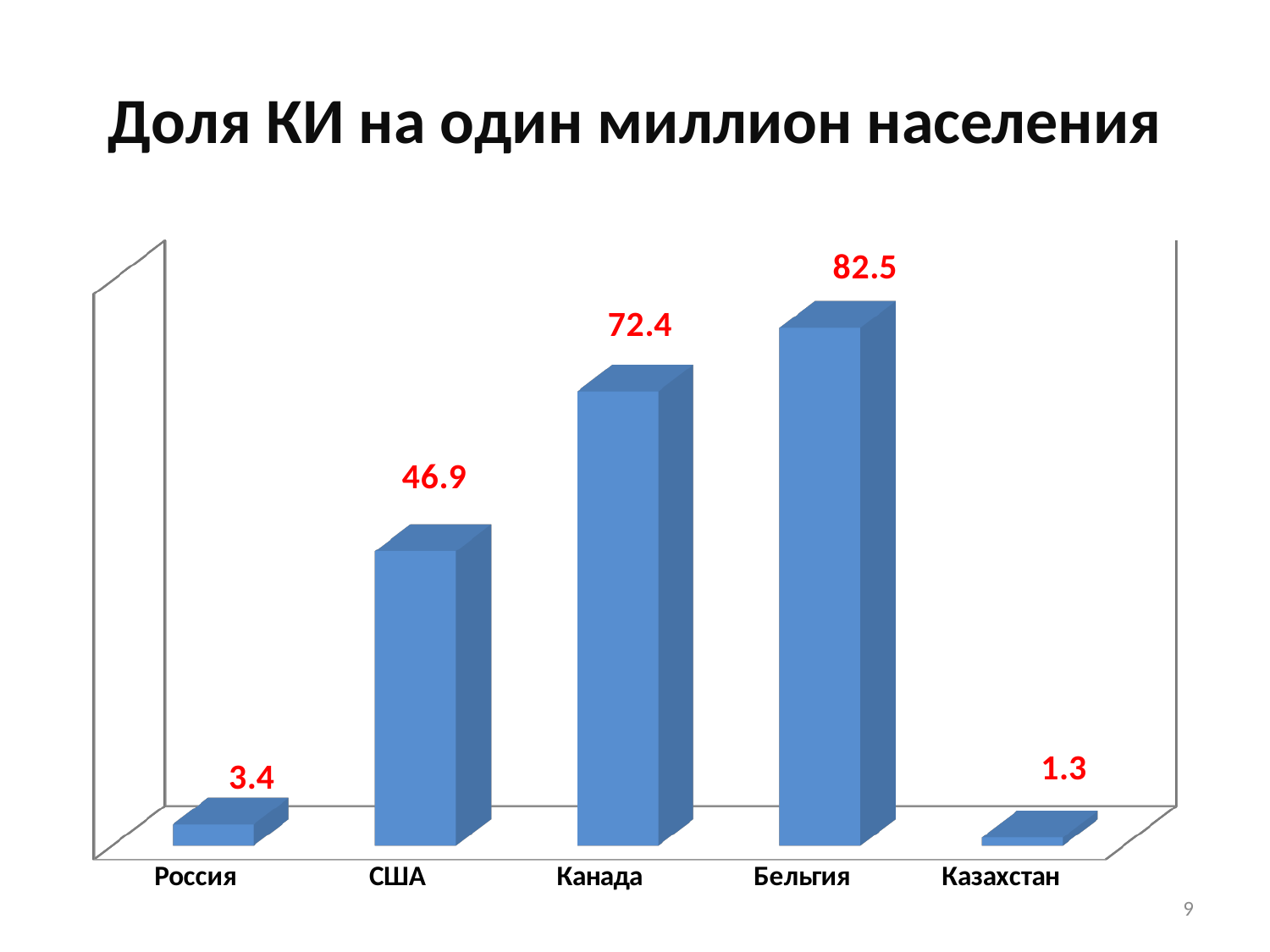
What is the title of the chart? Доля КИ на один миллион населения What is the value for Канада? 72.4 Which country has the highest value? Бельгия How many countries are shown in the chart? 5 What is the value for США? 46.9 What kind of chart is shown on the slide? bar chart What is the difference between the values for Бельгия and Канада? 10.1 What is the value for Россия? 3.4 Which is larger, the value for США or the value for Канада? Канада What is the difference between the values for США and Россия? 43.5 Which country has the lowest value? Казахстан What is the value for Казахстан? 1.3